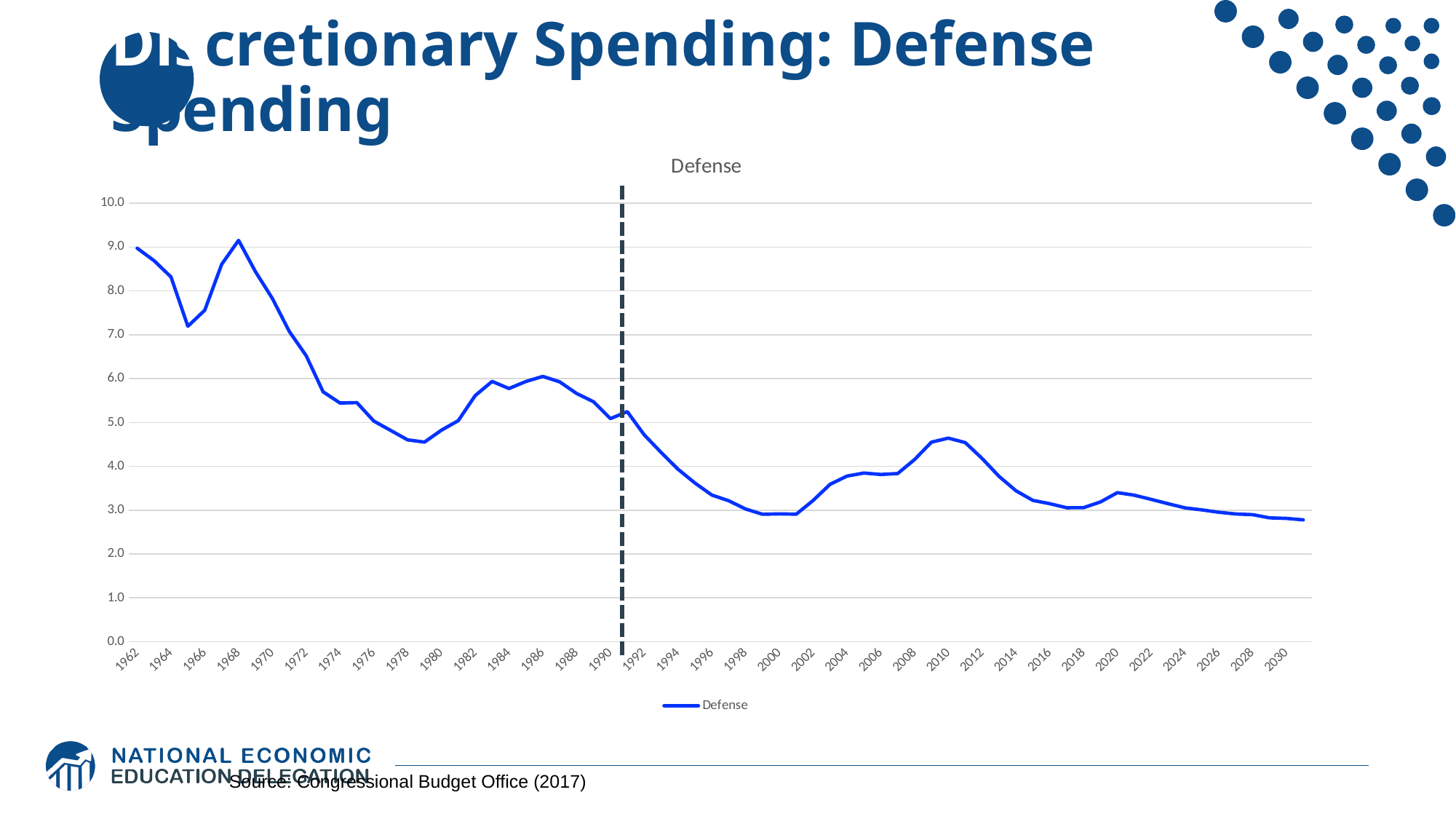
Overall, does the Defense line rise or fall from 1962 to 2030? fall What kind of chart is shown on the slide? line chart Does the Defense line rise or fall between 2000 and 2010? rise Is the value for 2010 greater or less than 4.0? greater What is the title of the chart? Defense Is the value for 1962 greater or less than 8.0? greater What is the name of the series shown in the legend? Defense Is the value for 1972 greater or less than 7.0? less How many series does the legend list? 1 Which year has the larger value, 1968 or 2010? 1968